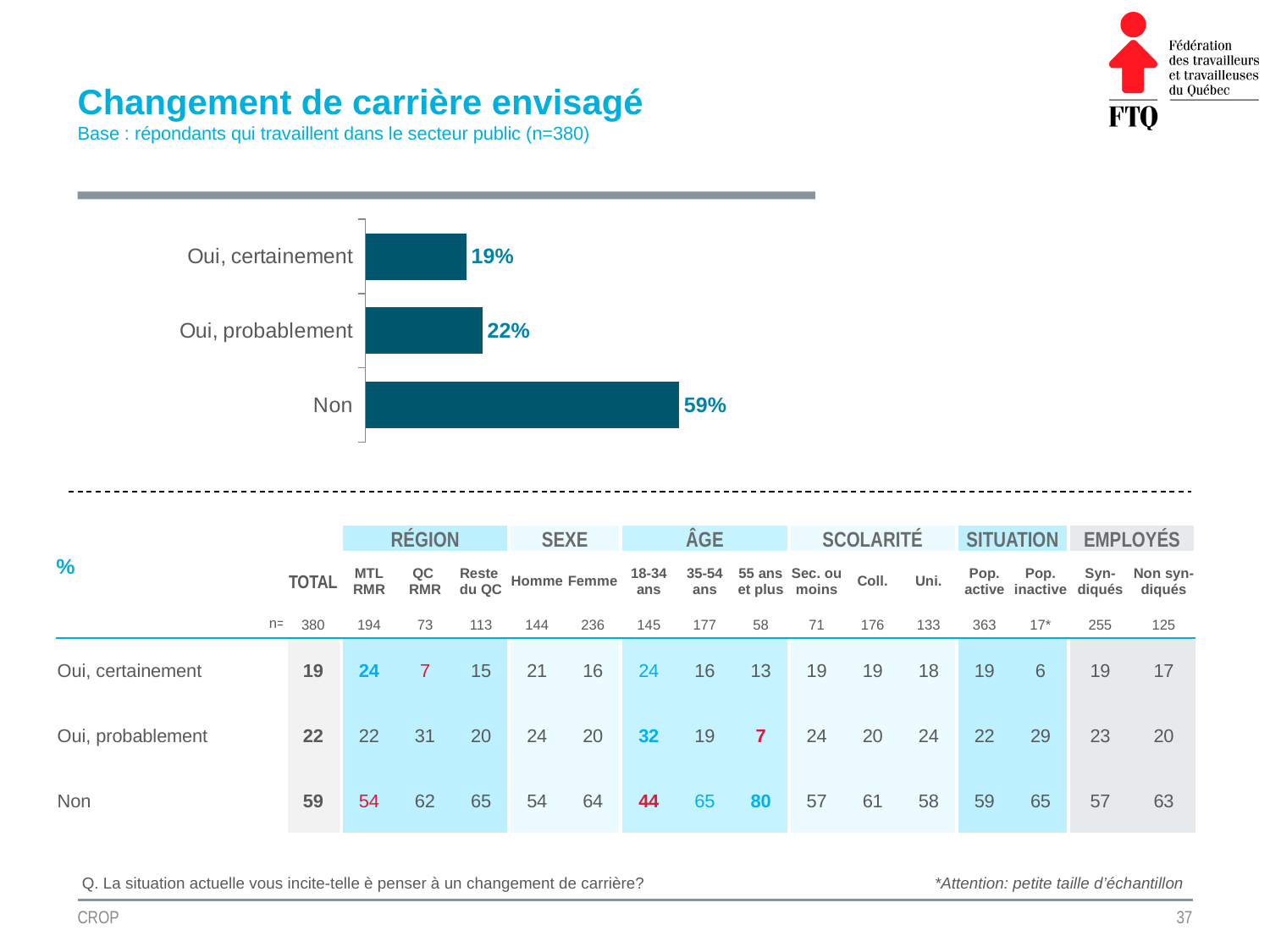
How many categories are shown in the chart? 3 What is the title of the slide containing the chart? Changement de carrière envisagé What is the combined value of "Oui, certainement" and "Oui, probablement"? 41% Which is larger, the value for "Oui, probablement" or the value for "Oui, certainement"? Oui, probablement What is the value for "Oui, certainement" in the chart? 19% What is the difference between the values for "Non" and "Oui, probablement"? 37% Which category has the highest value in the chart? Non What is the difference between the values for "Oui, probablement" and "Oui, certainement"? 3% What kind of chart is shown on the slide? Bar chart What is the value for "Oui, probablement" in the chart? 22% Which category has the lowest value in the chart? Oui, certainement What is the value for "Non" in the chart? 59%